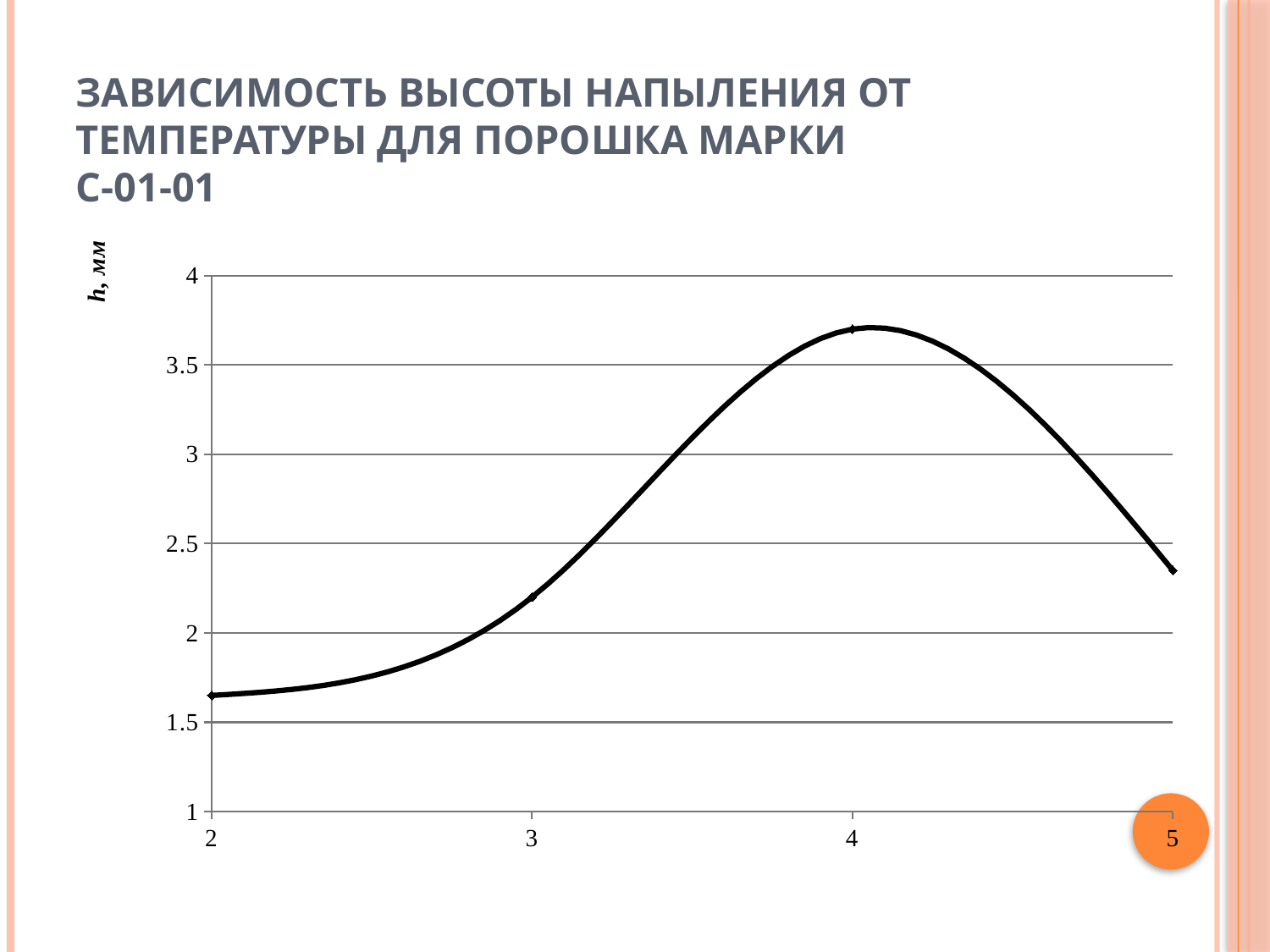
What kind of chart is shown on the slide? line chart How does the line behave as x increases from 2 to 5? rises until x = 4, then falls Which is larger, the value at x = 3 or the value at x = 4? x = 4 At which x-axis value does the line reach its highest point? 4 Is the value at x = 4 greater or less than 3.5? greater Which is larger, the value at x = 2 or the value at x = 5? x = 5 At which x-axis value does the line reach its lowest point? 2 How many data points are plotted on the line? 4 Is the value at x = 2 greater or less than 2? less What is the label on the vertical axis? h, мм Is the value at x = 3 greater or less than 2? greater